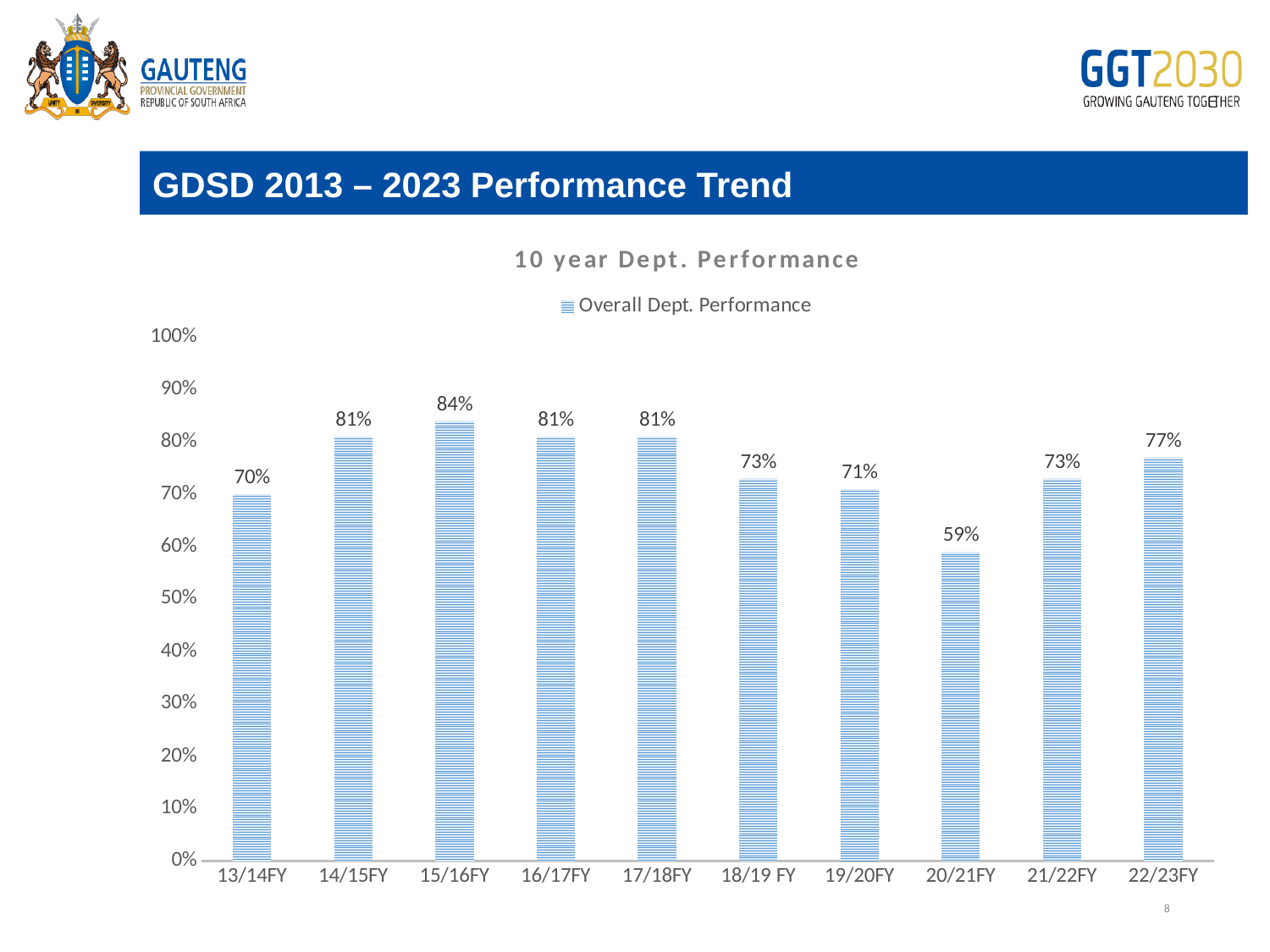
What is the Overall Dept. Performance value for 20/21FY? 59% What kind of chart is shown on the slide? bar chart What is the title of the chart? 10 year Dept. Performance How many financial years are shown on the x axis of the chart? 10 What is the Overall Dept. Performance value for 13/14FY? 70% Is the Overall Dept. Performance for 18/19 FY greater or less than 80%? less Which financial year has the highest Overall Dept. Performance? 15/16FY Which is larger, the Overall Dept. Performance for 19/20FY or for 22/23FY? 22/23FY How many series does the chart legend list? 1 What is the Overall Dept. Performance value for 22/23FY? 77% Which financial year has the lowest Overall Dept. Performance? 20/21FY What is the difference between the Overall Dept. Performance for 15/16FY and 20/21FY? 25%